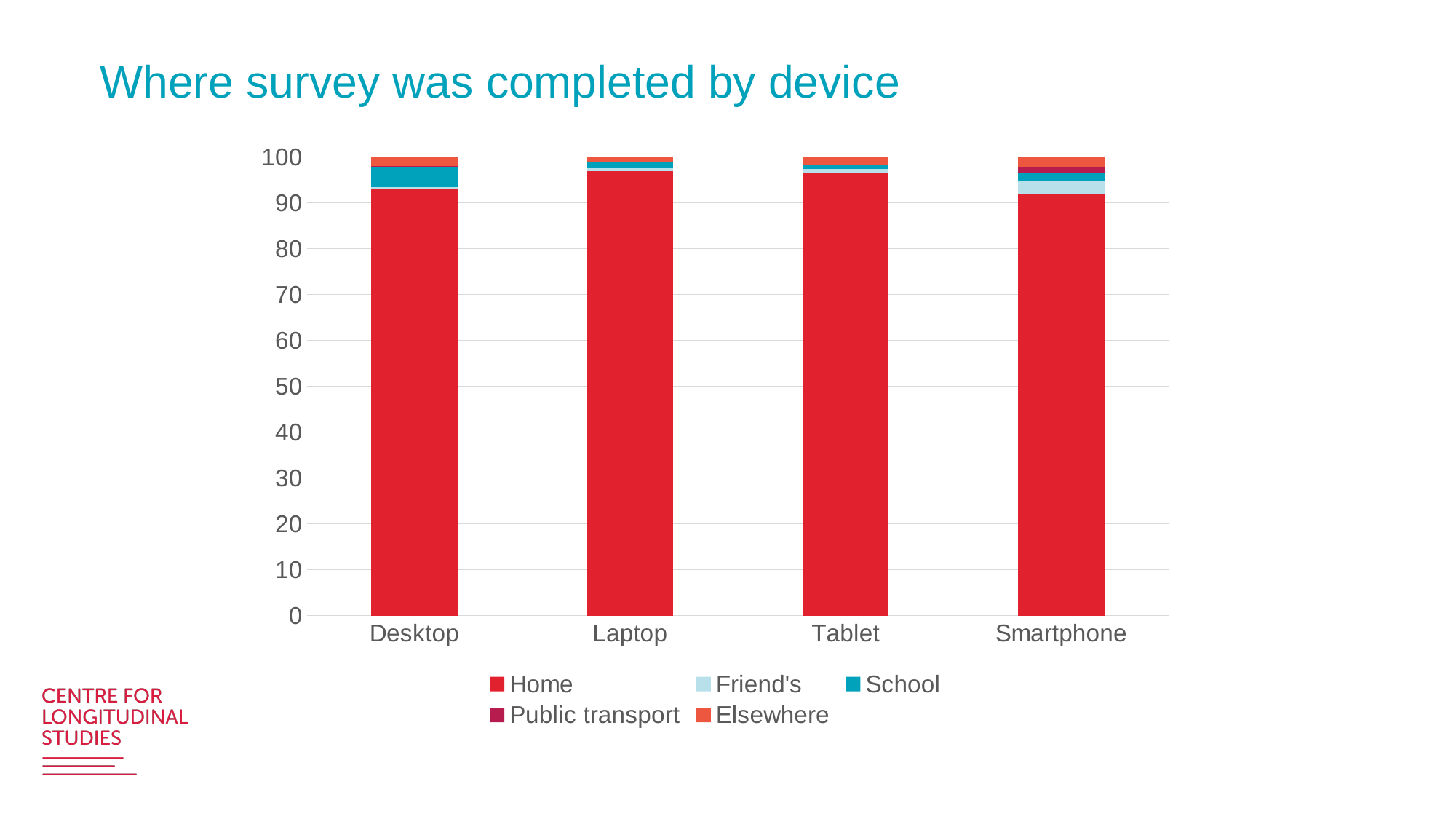
What type of chart is shown on the slide? Stacked bar chart What is the total height of the stacked bar for Desktop? 100 Which has a larger Home value, Laptop or Smartphone? Laptop How many series does the legend list? 5 Is the Home value for Smartphone greater or less than 80? greater Is the Home value for Desktop greater or less than 90? greater Is the Home value for Tablet greater or less than 100? less What is the total height of the stacked bar for Smartphone? 100 How many device categories are shown on the x axis? 4 What is the title of the chart? Where survey was completed by device